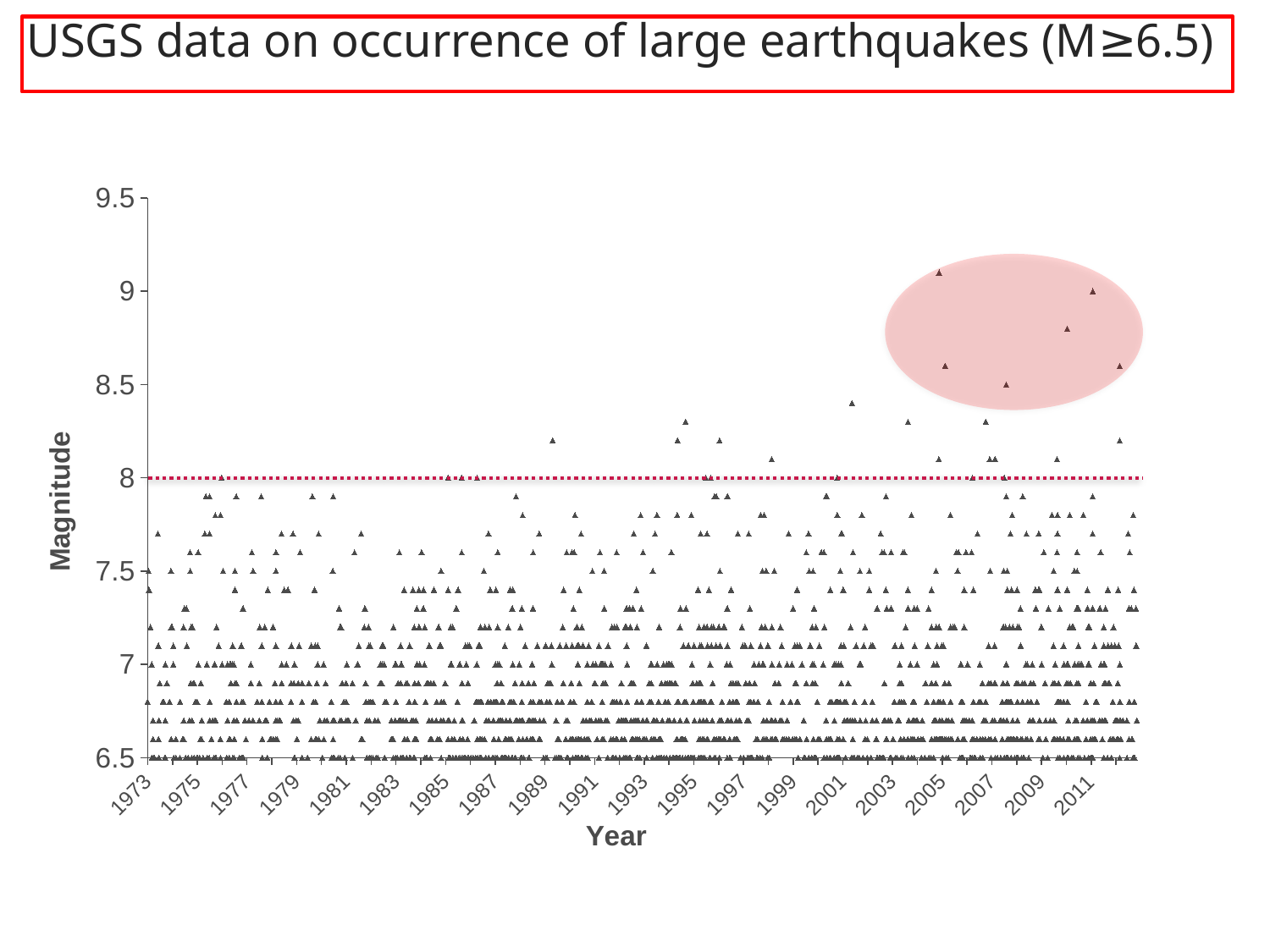
Is the highest magnitude plotted greater or less than 8.5? greater What is the label of the vertical axis? Magnitude Are the points inside the pink ellipse above or below the dotted line at magnitude 8? above What is the title of the slide's chart? USGS data on occurrence of large earthquakes (M≥6.5) What kind of chart is shown on the slide? scatter plot What is the lowest value shown on the Magnitude axis? 6.5 What is the first year labelled on the Year axis? 1973 What is the highest value shown on the Magnitude axis? 9.5 What is the last year labelled on the Year axis? 2011 Is the lowest magnitude plotted greater or less than 7? less At what magnitude is the horizontal dotted line drawn? 8 How many year labels are shown on the Year axis? 20